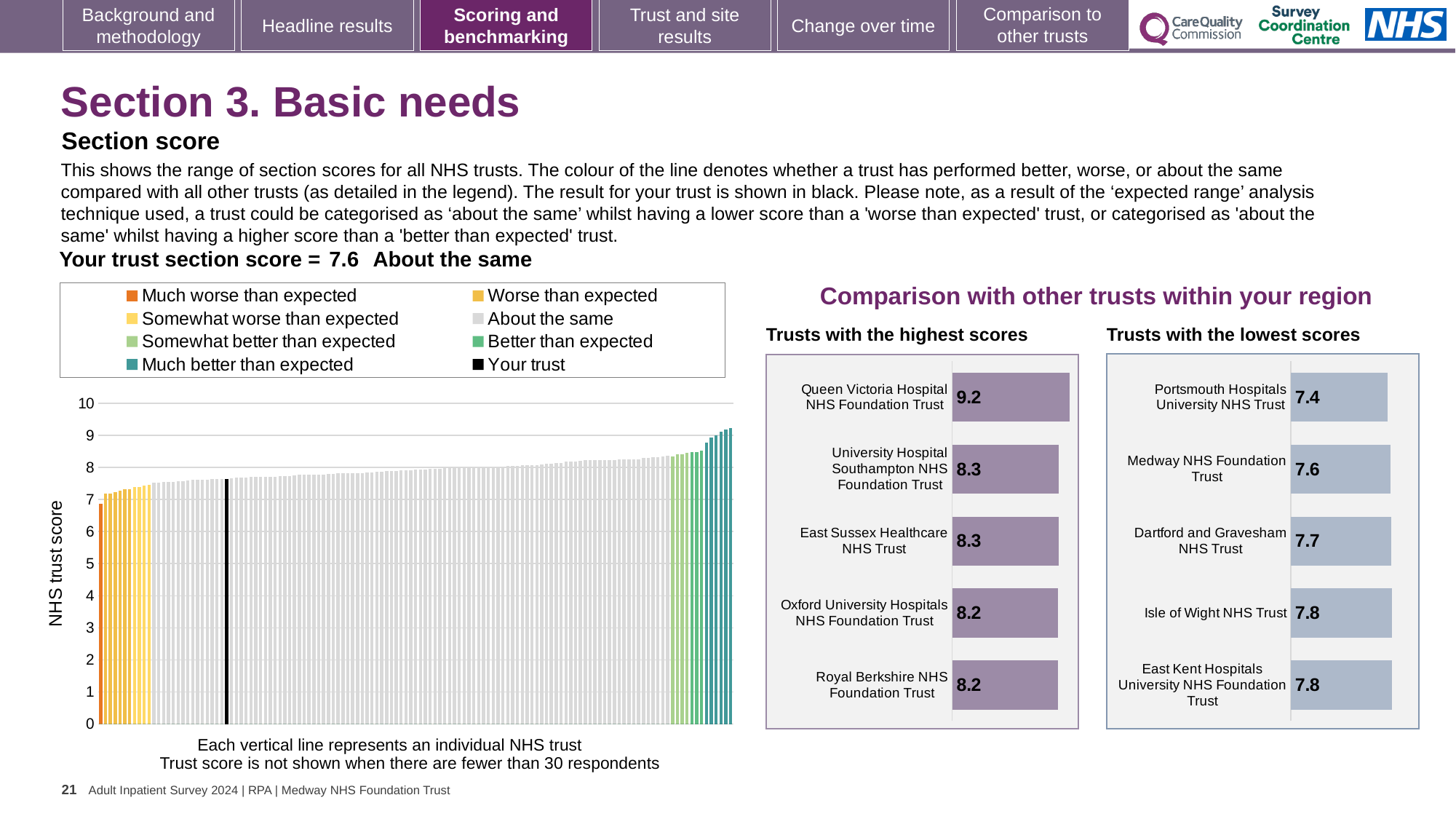
In the 'Trusts with the highest scores' chart, what is the score for Queen Victoria Hospital NHS Foundation Trust? 9.2 In the 'Trusts with the highest scores' chart, how many trusts are shown? 5 In the main chart on the left, do the trust scores rise or fall from left to right? Rise In the 'Trusts with the lowest scores' chart, what is the difference between the scores of East Kent Hospitals University NHS Foundation Trust and Portsmouth Hospitals University NHS Trust? 0.4 What kind of chart is the main chart on the left showing NHS trust scores? Bar chart In the 'Trusts with the lowest scores' chart, which trust has the lowest score? Portsmouth Hospitals University NHS Trust In the 'Trusts with the highest scores' chart, what is the difference between the scores of Queen Victoria Hospital NHS Foundation Trust and Royal Berkshire NHS Foundation Trust? 1.0 In the 'Trusts with the lowest scores' chart, which is larger: the score for Medway NHS Foundation Trust or the score for Isle of Wight NHS Trust? Isle of Wight NHS Trust In the 'Trusts with the lowest scores' chart, what is the score for Portsmouth Hospitals University NHS Trust? 7.4 In the 'Trusts with the lowest scores' chart, what is the score for Dartford and Gravesham NHS Trust? 7.7 In the main chart on the left showing NHS trust scores, how many entries does the legend list? 8 In the 'Trusts with the highest scores' chart, which trust has the highest score? Queen Victoria Hospital NHS Foundation Trust